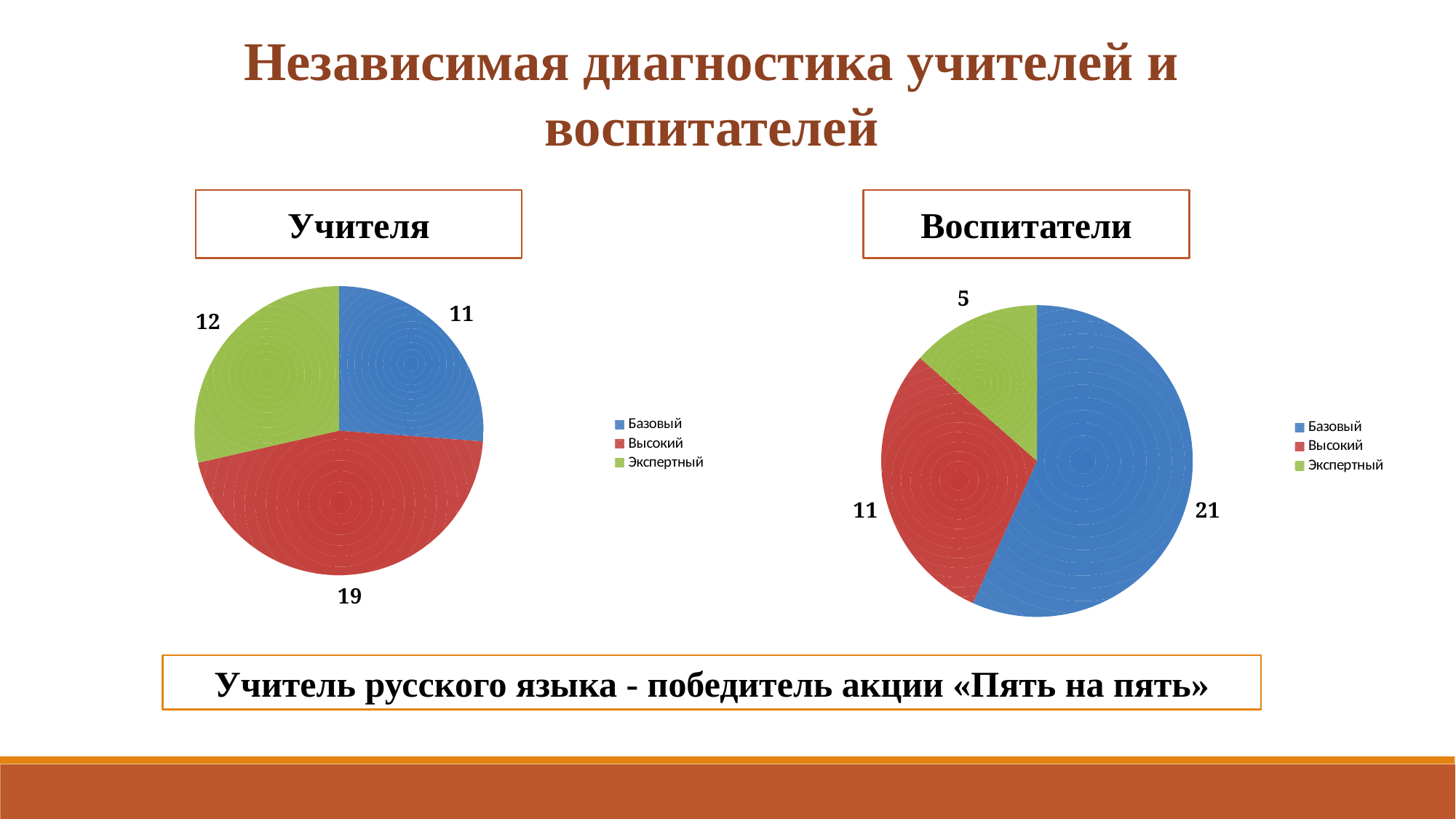
Which is larger: Базовый in the "Учителя" chart or Базовый in the "Воспитатели" chart? Воспитатели In the "Учителя" pie chart, what is the value for Базовый? 11 In the "Воспитатели" pie chart, what is the difference between Базовый and Экспертный? 16 In the "Учителя" pie chart, which category has the largest slice? Высокий In the "Учителя" pie chart, what is the difference between Высокий and Базовый? 8 In the "Воспитатели" pie chart, which category has the smallest slice? Экспертный In the "Учителя" pie chart, what is the value for Высокий? 19 What colour represents Экспертный in the legend of the "Воспитатели" chart? Green How many categories does the "Воспитатели" pie chart have? 3 In the "Воспитатели" pie chart, what is the value for Базовый? 21 In the "Воспитатели" pie chart, what is the value for Экспертный? 5 What type of chart is used for "Учителя"? Pie chart